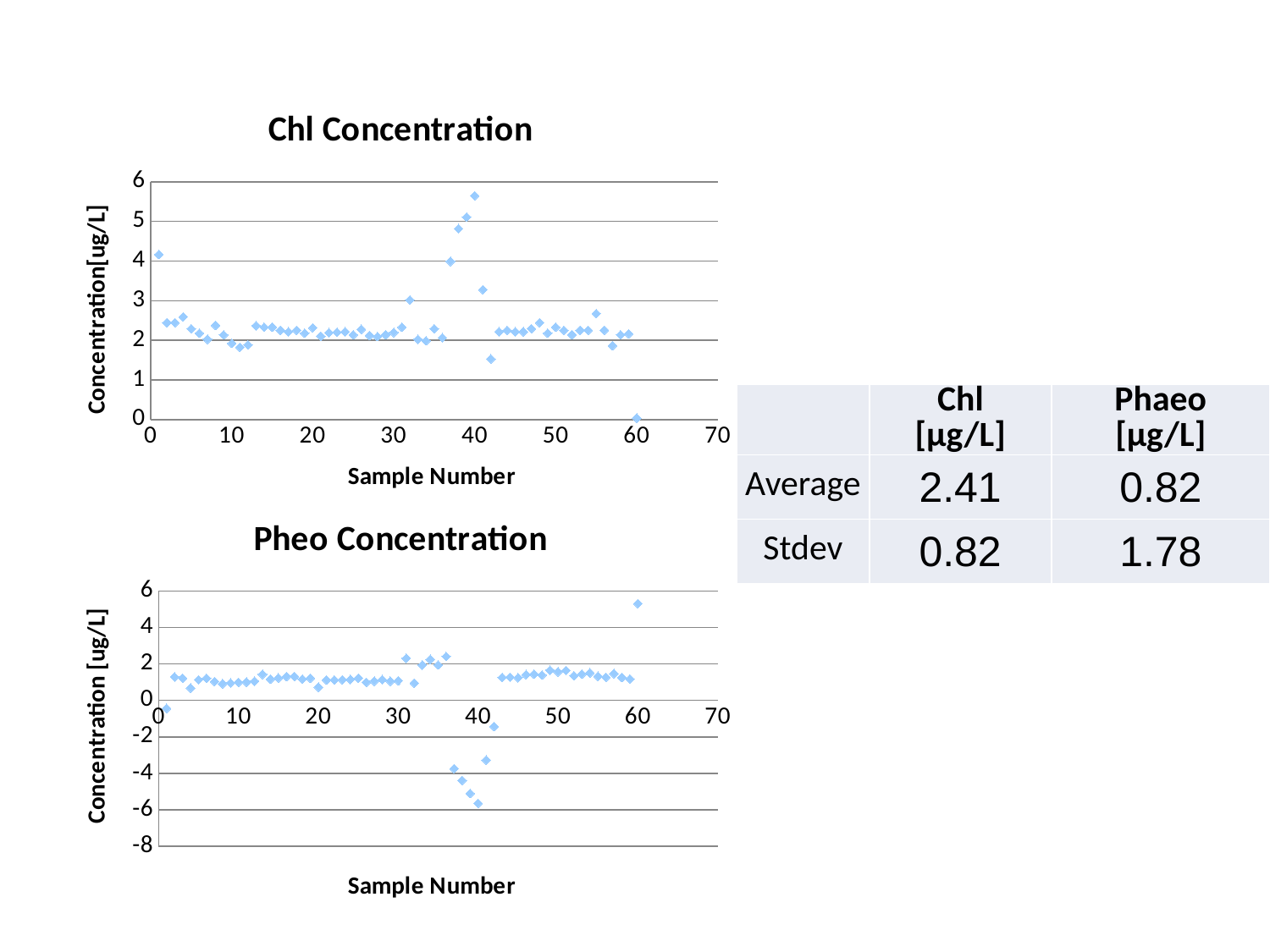
What is the x-axis label of the Chl Concentration chart? Sample Number In the Chl Concentration chart, which sample number has the lowest concentration? 60 In the Chl Concentration chart, is the value for sample 42 greater or less than 2? less In the Chl Concentration chart, is the value for sample 40 greater or less than 5? greater In the Chl Concentration chart, which has the larger value, sample 1 or sample 2? sample 1 What is the title of the lower chart on the slide? Pheo Concentration In the Pheo Concentration chart, is the value for sample 40 greater or less than -4? less In the Chl Concentration chart, which sample number has the highest concentration? 40 In the Pheo Concentration chart, which sample number has the highest concentration? 60 In the Pheo Concentration chart, which has the larger value, sample 36 or sample 37? sample 36 What kind of chart is the Chl Concentration chart? scatter chart